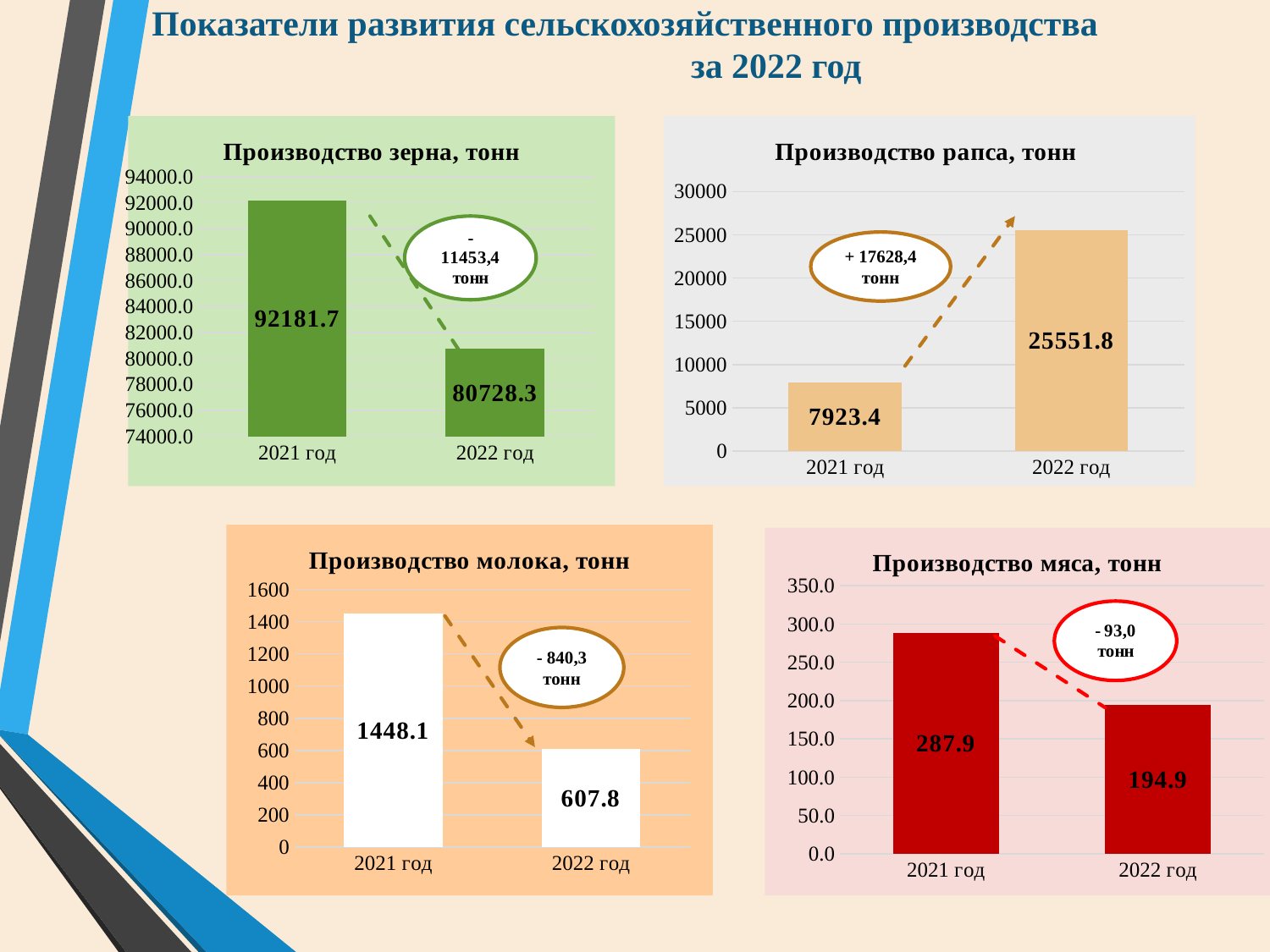
In the chart "Производство зерна, тонн", what is the value for 2021 год? 92181.7 In the chart "Производство рапса, тонн", which year has the lower value? 2021 год What kind of chart is "Производство мяса, тонн"? bar chart In the chart "Производство рапса, тонн", what is the value for 2022 год? 25551.8 In the chart "Производство зерна, тонн", by how much does the value for 2021 год exceed the value for 2022 год? 11453.4 In the chart "Производство мяса, тонн", which year has the higher value, 2021 год or 2022 год? 2021 год In the chart "Производство зерна, тонн", what is the value for 2022 год? 80728.3 In the chart "Производство молока, тонн", what is the difference between the 2021 год and 2022 год values? 840.3 In the chart "Производство молока, тонн", what is the value for 2021 год? 1448.1 How many charts are shown on the slide? 4 In the chart "Производство мяса, тонн", what is the value for 2022 год? 194.9 In the chart "Производство рапса, тонн", do the values rise or fall from 2021 год to 2022 год? rise